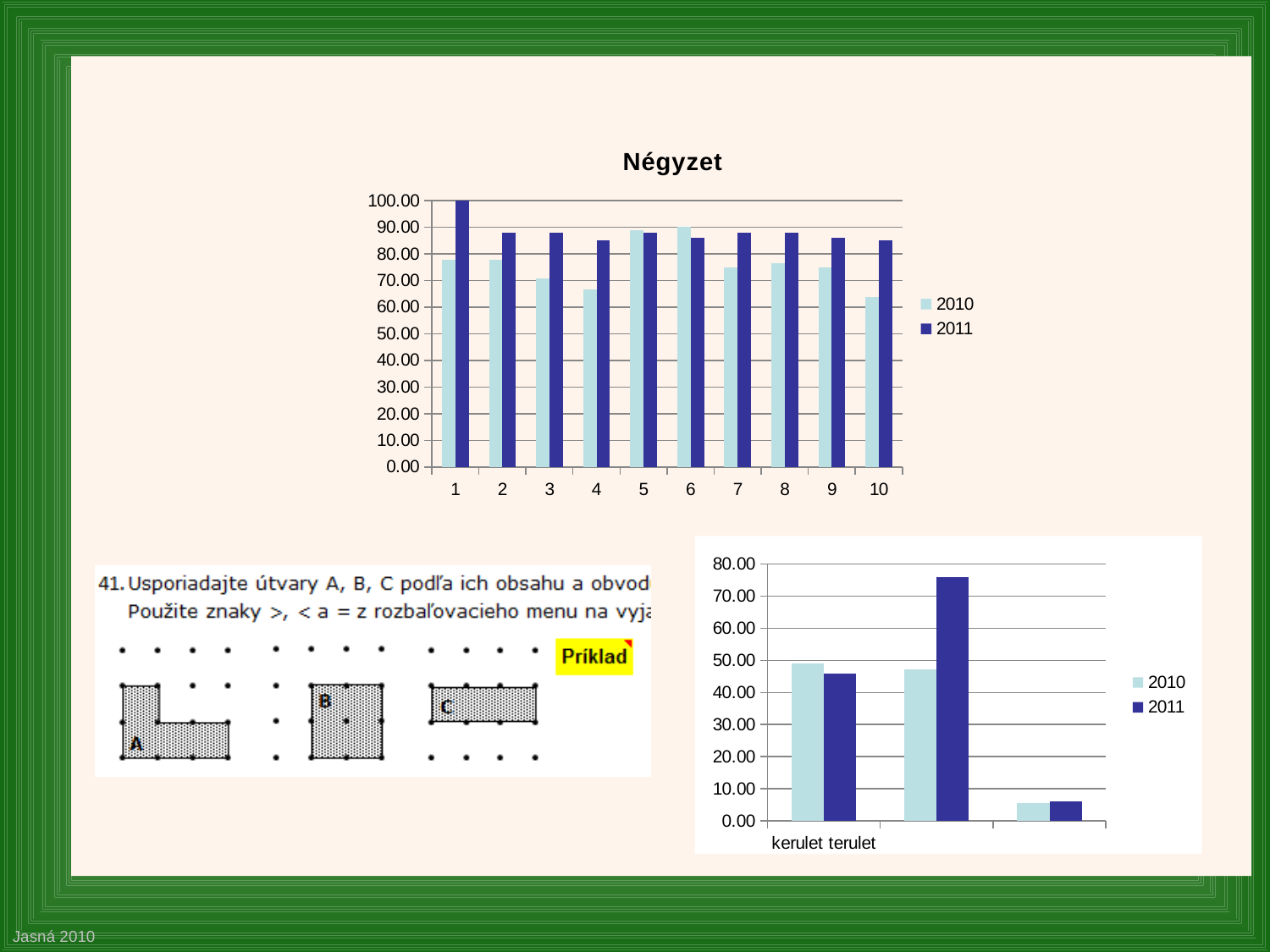
In the 'Négyzet' chart, is the 2010 value for category 4 greater or less than 70.00? less What kind of chart is the 'Négyzet' chart? bar chart How many series does the legend of the 'Négyzet' chart list? 2 In the bottom-right chart, which series contains the tallest bar? 2011 In the 'Négyzet' chart, what is the 2011 value for category 1? 100.00 In the 'Négyzet' chart, which category has the highest 2011 value? 1 What kind of chart is the chart in the bottom right of the slide? bar chart How many categories are shown on the x axis of the 'Négyzet' chart? 10 In the 'Négyzet' chart, is the 2011 value for category 2 greater or less than 80.00? greater In the 'Négyzet' chart, which category has the lowest 2010 value? 10 In the bottom-right chart, is the 2010 value for 'kerulet terulet' greater or less than 40.00? greater In the 'Négyzet' chart, for category 1, which series has the larger value, 2010 or 2011? 2011